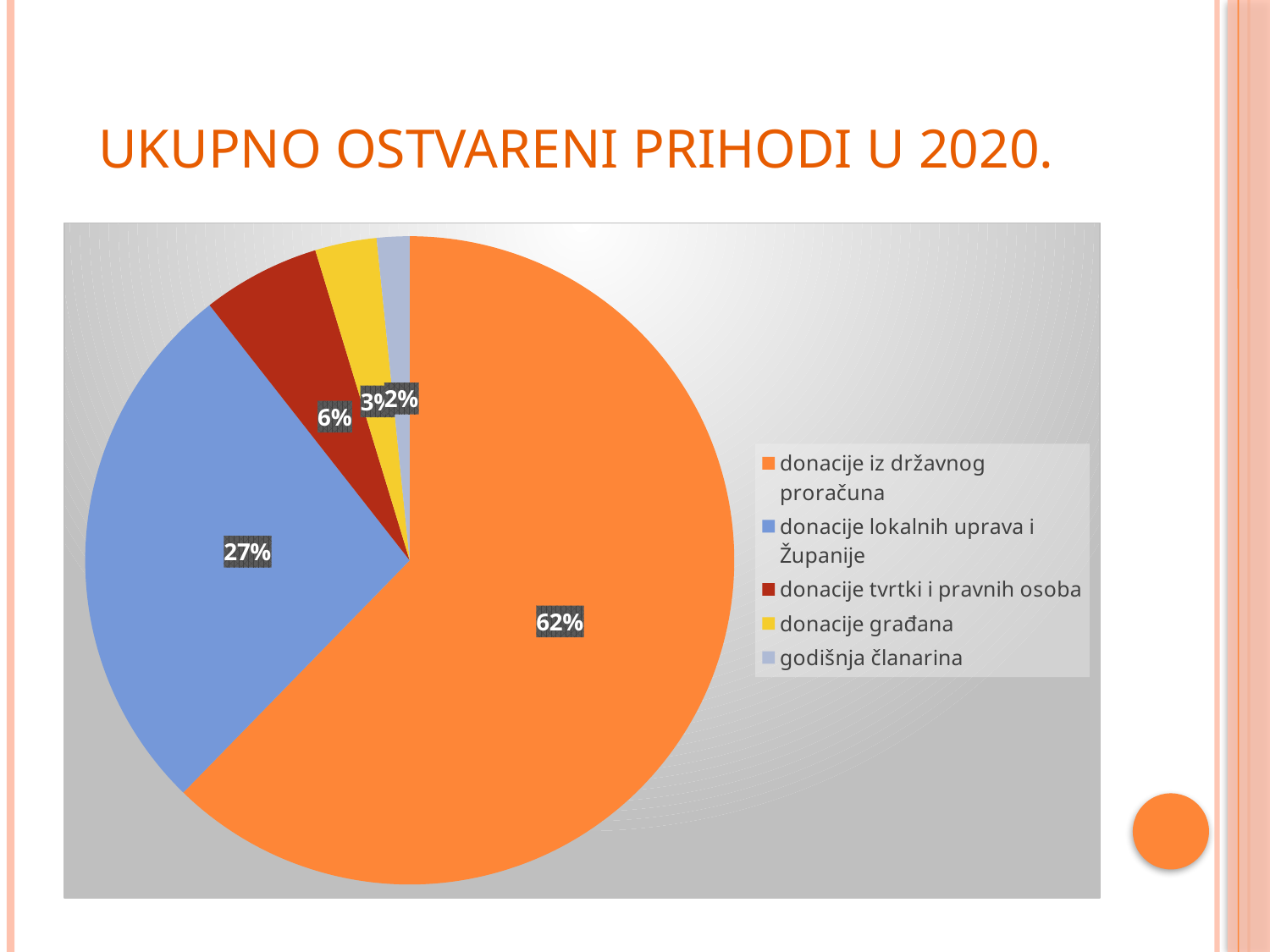
What kind of chart is shown on the slide? pie chart Which category has the smallest slice of the pie? godišnja članarina What is the value shown for "donacije građana"? 3% What is the difference in percentage points between "donacije iz državnog proračuna" and "donacije lokalnih uprava i Županije"? 35 Which category has the largest slice of the pie? donacije iz državnog proračuna What share of the pie does "donacije iz državnog proračuna" have? 62% What is the title of the slide containing the chart? UKUPNO OSTVARENI PRIHODI U 2020. How many categories does the legend list? 5 What is the value shown for "godišnja članarina"? 2% Which is larger, "donacije tvrtki i pravnih osoba" or "donacije građana"? donacije tvrtki i pravnih osoba What is the value shown for "donacije tvrtki i pravnih osoba"? 6% What share of the pie does "donacije lokalnih uprava i Županije" have? 27%